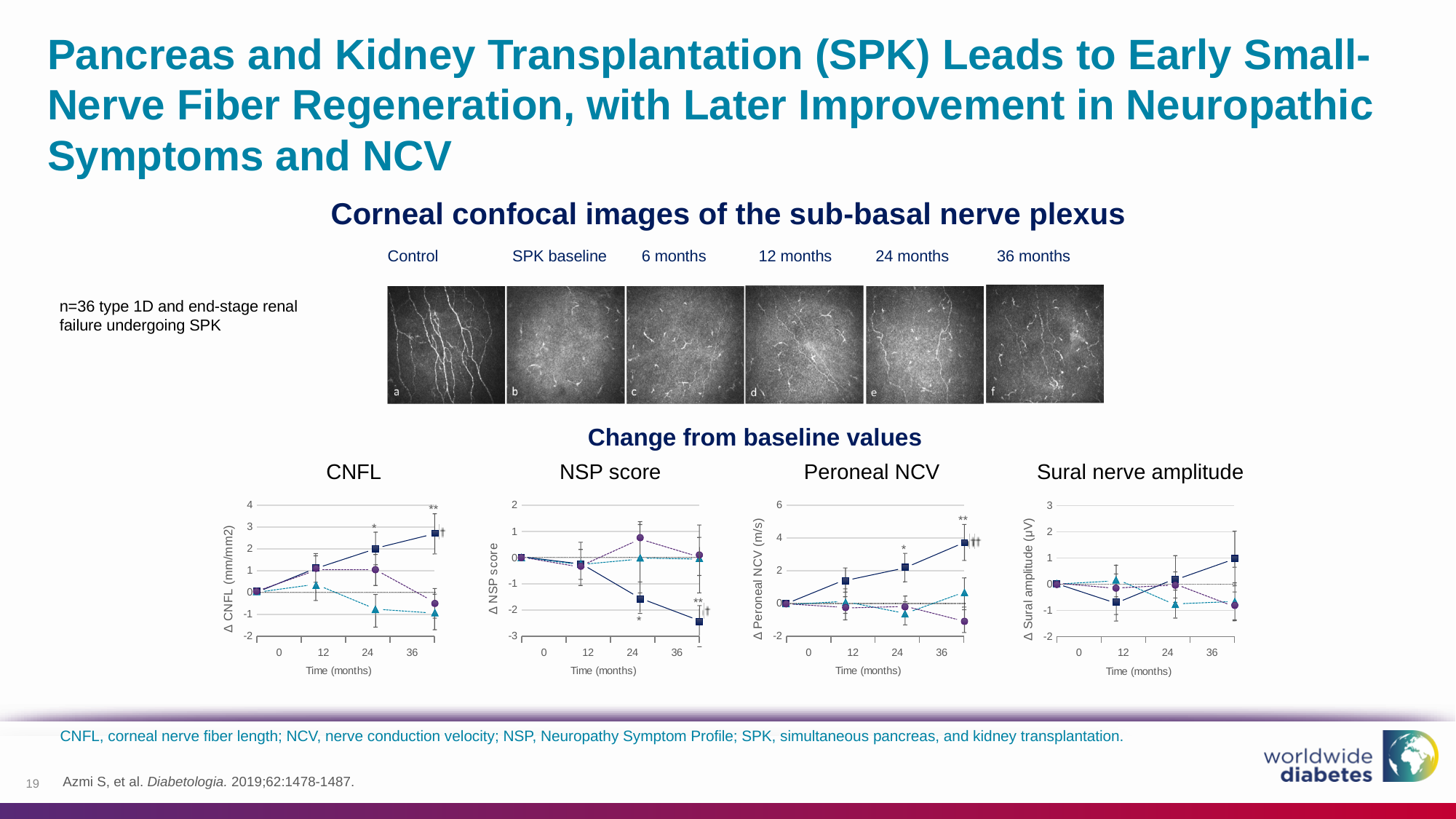
What is the x-axis label on the Peroneal NCV chart? Time (months) In the Peroneal NCV chart, does the solid dark blue line with square markers rise or fall from 0 to 36 months? Rises In the Peroneal NCV chart, is the value of the solid dark blue square-marker series at 36 months greater or less than 2? greater In the CNFL chart, is the value of the solid dark blue square-marker series at 36 months greater or less than 2? greater In the CNFL chart, how many time points are labelled on the x axis? 4 In the CNFL chart, which series has the highest value at 36 months? The solid dark blue line with square markers In the CNFL chart, does the solid dark blue line with square markers rise or fall from 0 to 36 months? Rises How many charts are shown under the heading 'Change from baseline values'? 4 In the NSP score chart, does the solid dark blue line with square markers rise or fall from 0 to 36 months? Falls What kind of chart is the CNFL chart? Line chart In the NSP score chart, is the value of the solid dark blue square-marker series at 36 months greater or less than -2? less What is the y-axis label on the Sural nerve amplitude chart? Δ Sural amplitude (µV)